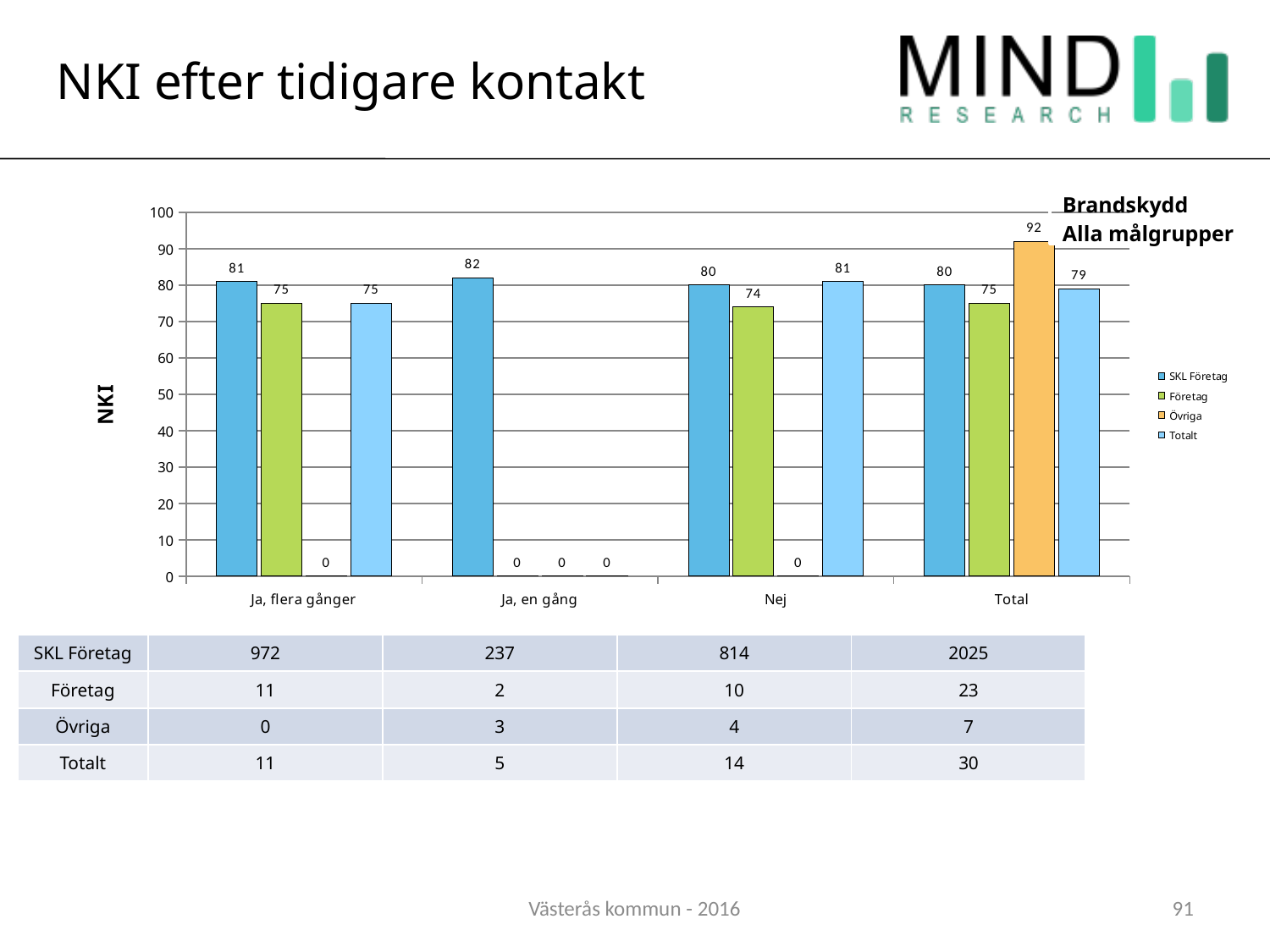
What is the NKI value for SKL Företag in the 'Ja, flera gånger' category? 81 How many series does the chart legend list? 4 What is the NKI value for Företag in the 'Nej' category? 74 How many categories are shown on the x axis of the chart? 4 What is the NKI value for Totalt in the 'Total' category? 79 Which series has the highest NKI value in the 'Total' category? Övriga What is the difference between the SKL Företag value and the Företag value in the 'Ja, flera gånger' category? 6 Which series has the lowest non-zero NKI value in the 'Nej' category? Företag Which is larger in the 'Nej' category: the SKL Företag value or the Totalt value? Totalt What is the NKI value for Övriga in the 'Total' category? 92 What is the label on the vertical axis of the chart? NKI What type of chart is shown on the slide? Bar chart